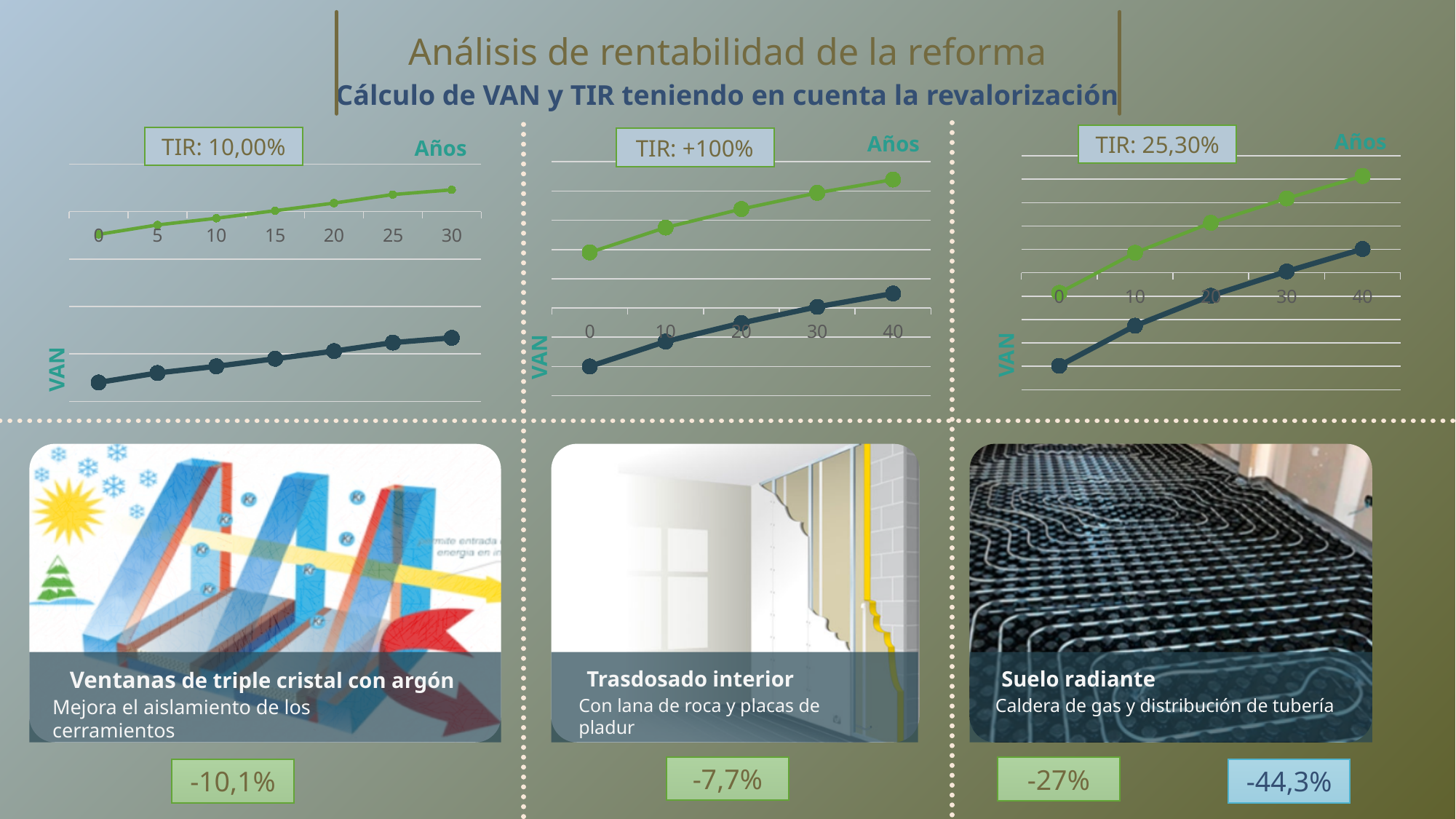
What TIR value is shown above the left chart? TIR: 10,00% In the right chart (TIR: 25,30%), what is the last value shown on the x axis? 40 What kind of chart is the left chart (TIR: 10,00%)? line chart In the right chart (TIR: 25,30%), how many lines are plotted? 2 In the left chart (TIR: 10,00%), how many points are plotted on each line? 7 What TIR value is shown above the right chart? TIR: 25,30% In the left chart (TIR: 10,00%), what is the spacing between consecutive x-axis ticks? 5 In the middle chart (TIR: +100%), how many points are plotted on each line? 5 In the right chart (TIR: 25,30%), does the dark blue line rise or fall along the x axis? rises In the left chart (TIR: 10,00%), does the green line rise or fall as the years increase? rises In the middle chart (TIR: +100%), which line is higher at 40 years, the green line or the dark blue line? green line In the left chart (TIR: 10,00%), what is the last value shown on the x axis? 30